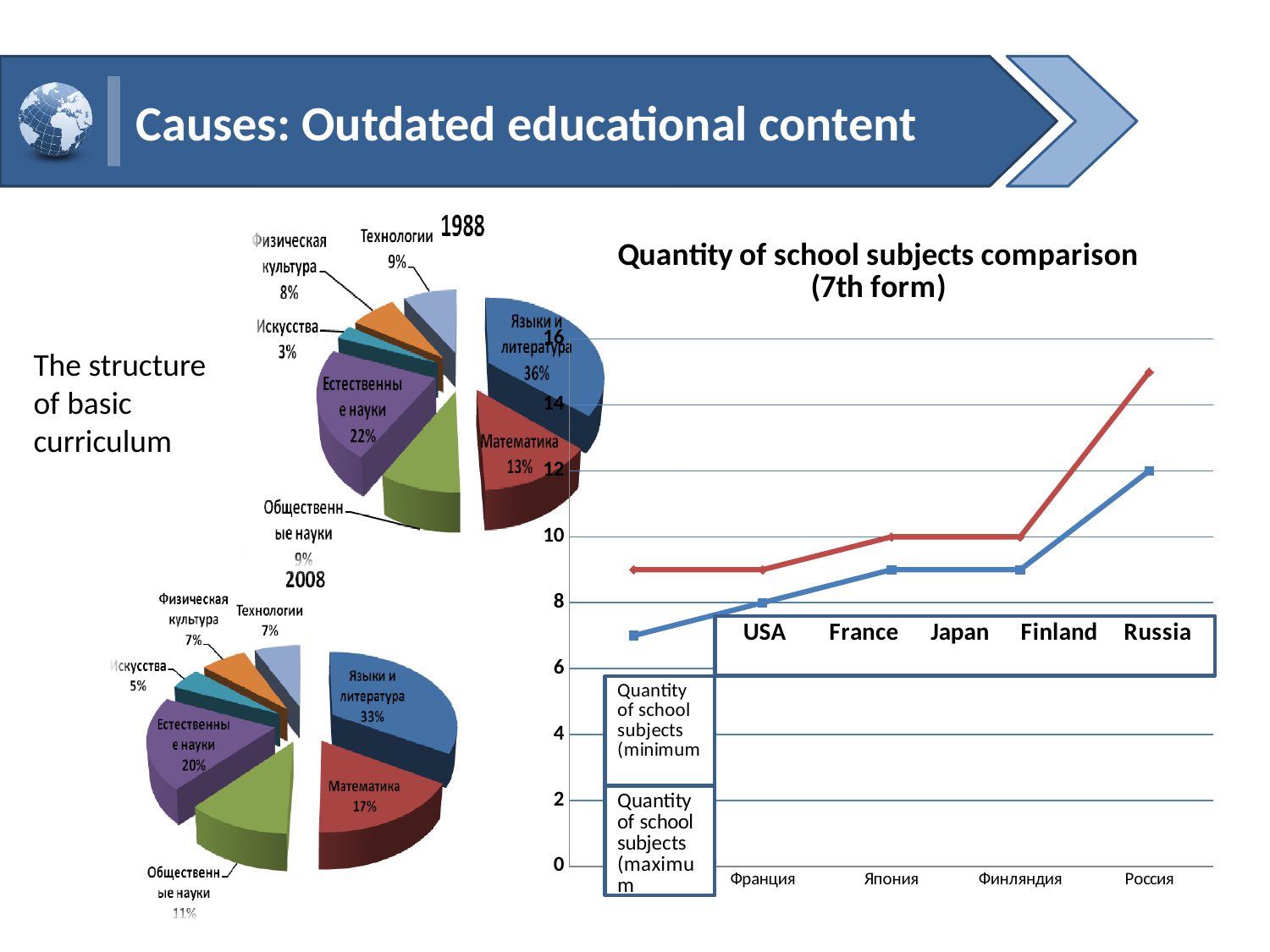
In the 'Quantity of school subjects comparison (7th form)' chart, do the values rise or fall from USA to Russia? rise In the 2008 pie chart, what is the difference between the shares of Естественные науки and Общественные науки? 9% In the 'Quantity of school subjects comparison (7th form)' chart, is the minimum value for USA greater or less than 8? less In the 2008 pie chart, what share does Математика have? 17% In the 2008 pie chart, which category has the largest share? Языки и литература In the 1988 pie chart, which category has the smallest share? Искусства In the 1988 pie chart, what share does Языки и литература have? 36% In the 1988 pie chart, which is larger: the share of Физическая культура or the share of Технологии? Технологии In the 'Quantity of school subjects comparison (7th form)' chart, is the maximum value for Russia greater or less than 14? greater How many categories does the 2008 pie chart show? 7 What kind of chart is 'Quantity of school subjects comparison (7th form)'? line chart